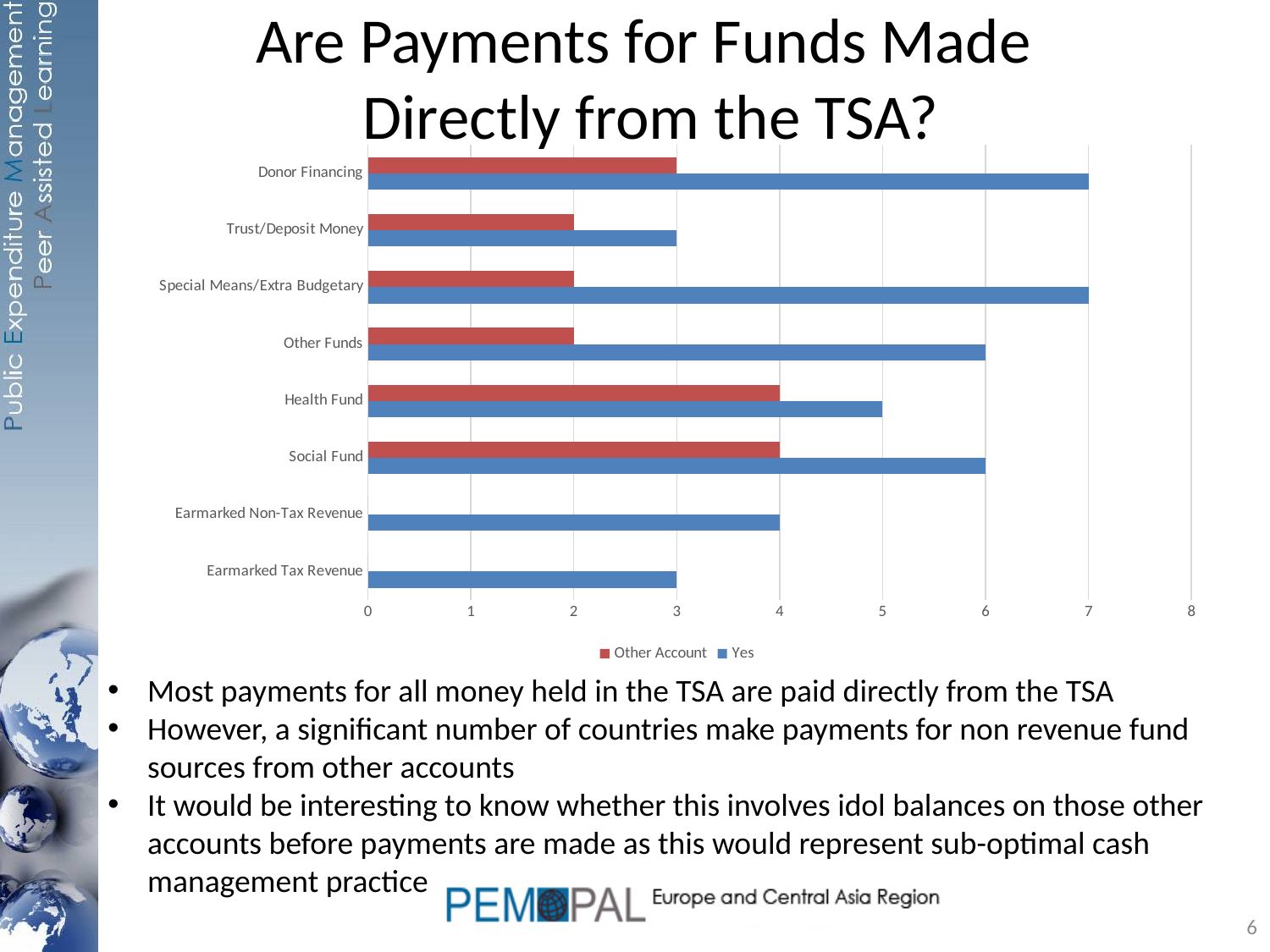
What is the 'Other Account' value for Health Fund? 4 How many series does the chart legend list? 2 What is the 'Yes' value for Earmarked Non-Tax Revenue? 4 What is the difference between the 'Yes' and 'Other Account' values for Donor Financing? 4 Is the 'Yes' value for Other Funds greater or less than 5? greater For Social Fund, which is larger: the 'Yes' value or the 'Other Account' value? Yes How many fund categories are shown on the chart? 8 Which series is shown in red in the chart? Other Account What is the title of the slide containing the chart? Are Payments for Funds Made Directly from the TSA? What is the 'Yes' value for Donor Financing? 7 What is the 'Other Account' value for Trust/Deposit Money? 2 What type of chart is shown on the slide? bar chart